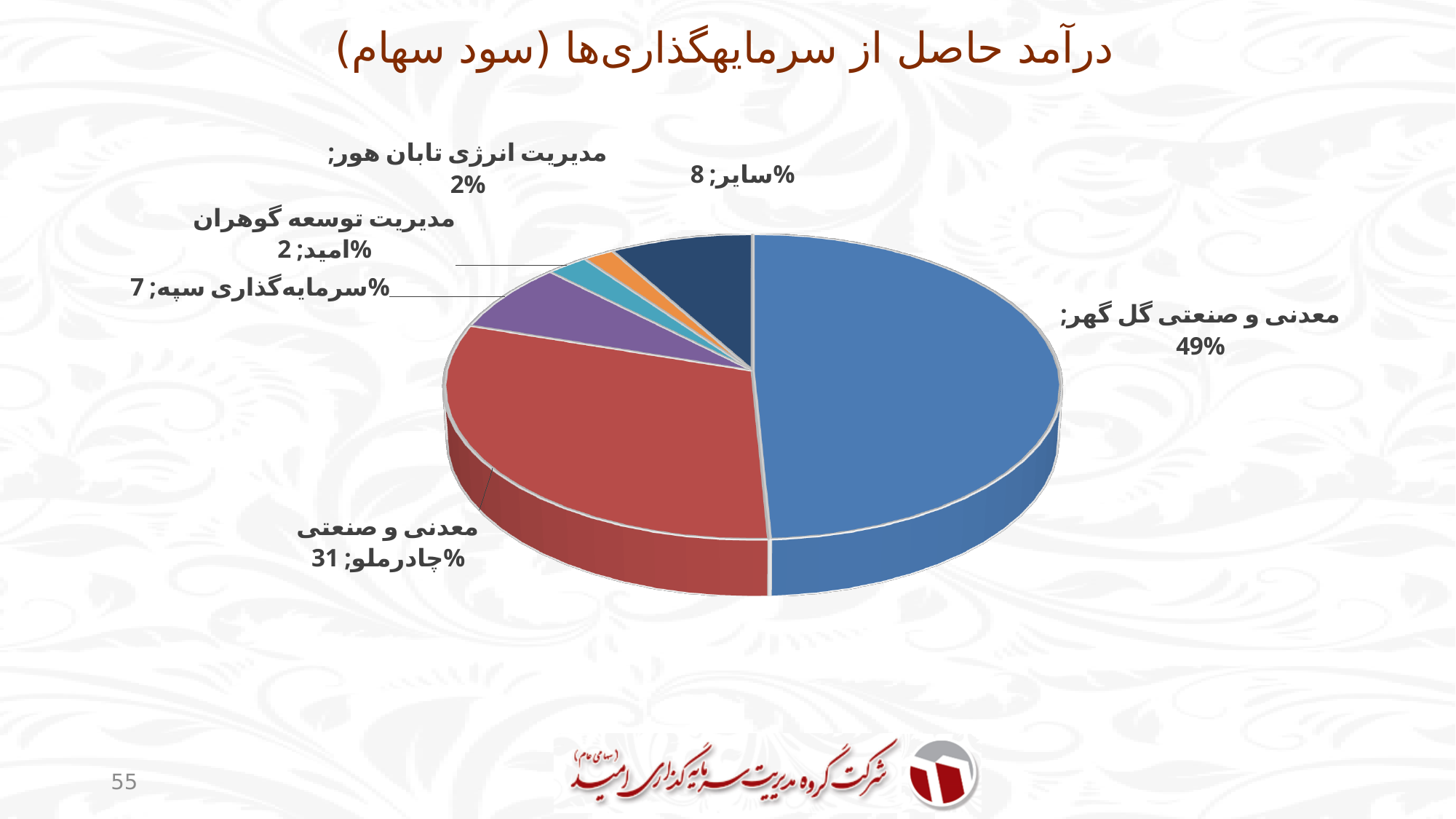
What is the difference in percentage points between معدنی و صنعتی گل گهر and معدنی و صنعتی چادرملو? 18 What is the share for مدیریت انرژی تابان هور? 2% What is the share for معدنی و صنعتی گل گهر? 49% What is the title of the chart? درآمد حاصل از سرمایه‌گذاری‌ها (سود سهام) Which slice has the largest share? معدنی و صنعتی گل گهر What kind of chart is shown on the slide? Pie chart What is the share for سایر? 8% What is the share for سرمایه‌گذاری سپه? 7% How many slices does the pie chart have? 6 What is the share for معدنی و صنعتی چادرملو? 31% Which is larger, the share for سایر or the share for سرمایه‌گذاری سپه? سایر What colour is the slice for معدنی و صنعتی چادرملو? Red